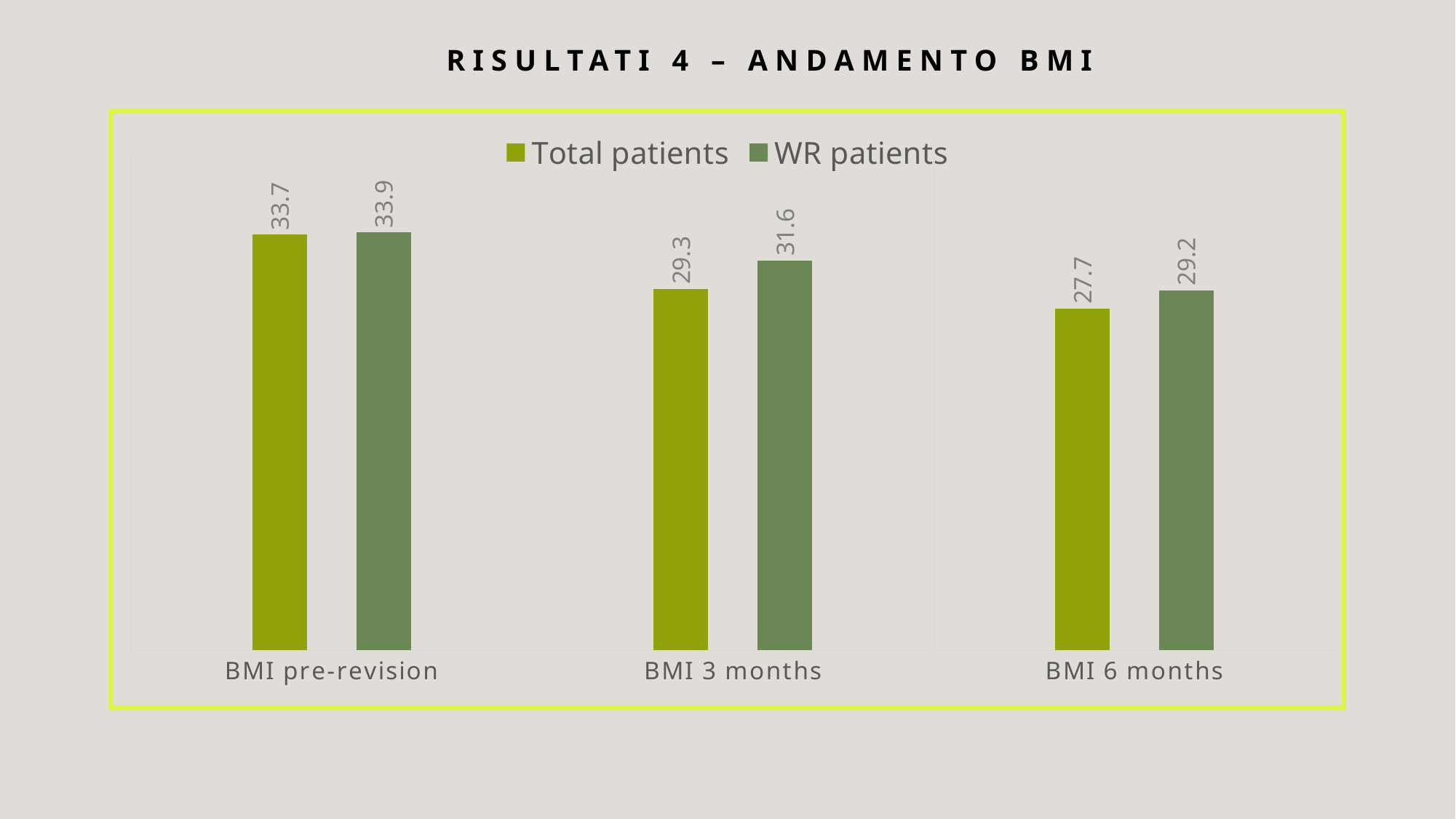
What is the value for WR patients at BMI 6 months? 29.2 What is the difference between WR patients and Total patients at BMI 3 months? 2.3 What is the value for Total patients at BMI 6 months? 27.7 How many series does the legend list? 2 Do the Total patients values rise or fall from BMI pre-revision to BMI 6 months? Fall Which category has the lowest value for Total patients? BMI 6 months How many categories are shown on the x axis? 3 What is the value for WR patients at BMI 3 months? 31.6 Which is larger at BMI 6 months, Total patients or WR patients? WR patients Which category has the highest value for WR patients? BMI pre-revision What kind of chart is shown on the slide? Bar chart What is the value for Total patients at BMI pre-revision? 33.7